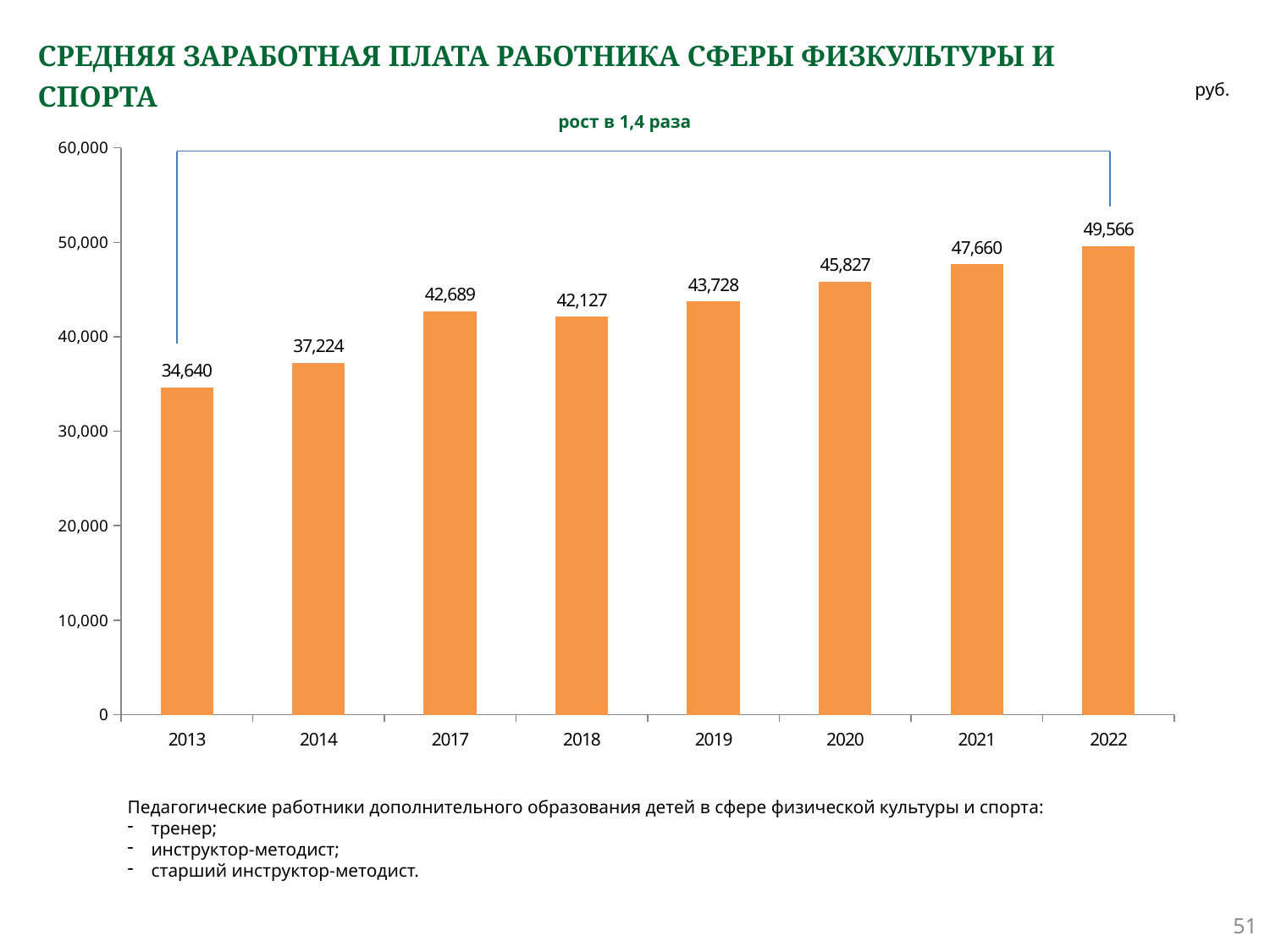
Is the value for 2020 greater or less than 40,000? greater What is the average salary value shown for 2013? 34,640 How many years are shown on the x axis? 8 What is the difference between the values for 2017 and 2018? 562 What is the value shown for 2019? 43,728 What is the value shown for 2022? 49,566 Which year has the lowest value? 2013 Which is larger, the value for 2017 or the value for 2018? 2017 What is the difference between the values for 2022 and 2013? 14,926 Which year has the highest value? 2022 What growth factor is stated in the annotation above the bars? рост в 1,4 раза What kind of chart is shown on the slide? bar chart